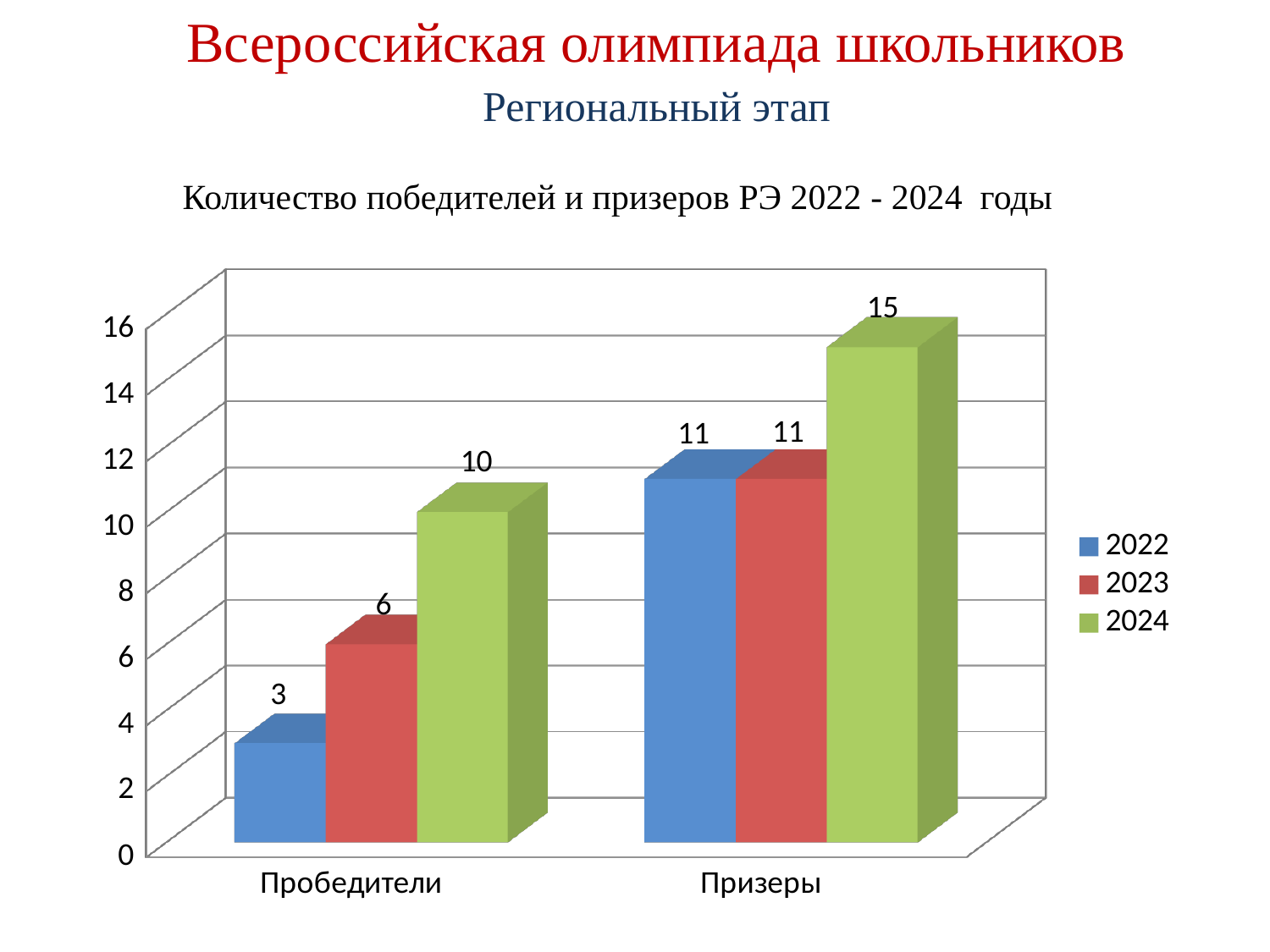
Which is larger: the 2023 value for Победители or the 2023 value for Призеры? Призеры What is the difference between the 2024 and 2023 values for Призеры? 4 Which year has the highest value in the Призеры category? 2024 What is the title of the chart? Количество победителей и призеров РЭ 2022 - 2024 годы Which year has the lowest value in the Победители category? 2022 What is the value for 2024 in the Победители category? 10 What kind of chart is shown on the slide? Bar chart How many series does the legend list? 3 What is the difference between the 2024 and 2022 values for Победители? 7 What is the value for 2023 in the Победители category? 6 What is the value for 2022 in the Призеры category? 11 How many categories are shown on the x axis? 2